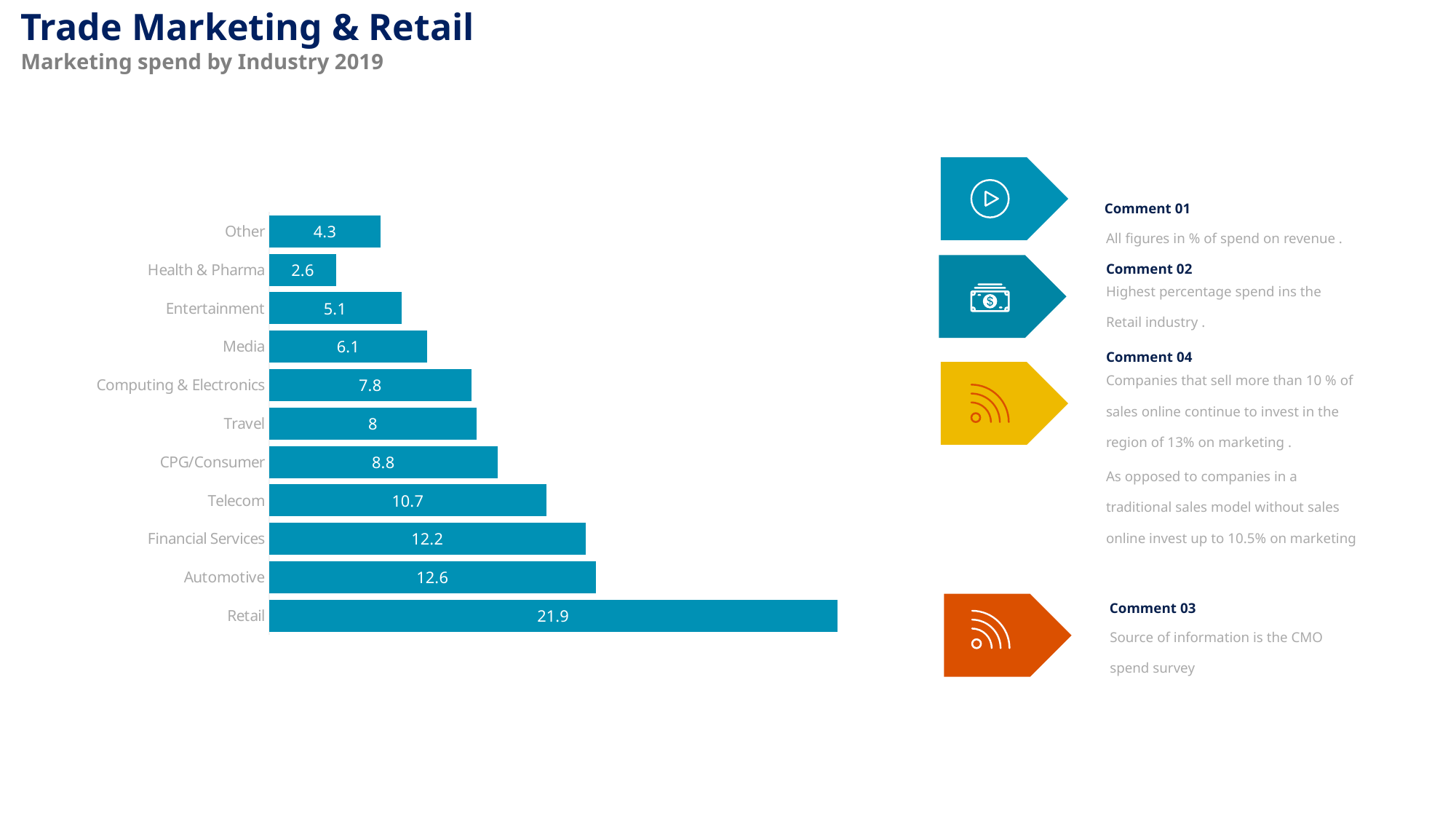
Which is larger, the value for Media or the value for Entertainment? Media What is the value for Telecom? 10.7 What is the value for Travel? 8 What is the value for Computing & Electronics? 7.8 What kind of chart is shown on the slide? Bar chart What is the value for Health & Pharma? 2.6 What is the difference between the values for Retail and Telecom? 11.2 What is the value for Retail? 21.9 How many industries are shown in the chart? 11 Which industry has the lowest value? Health & Pharma What is the difference between the values for Automotive and Financial Services? 0.4 Which industry has the highest value? Retail